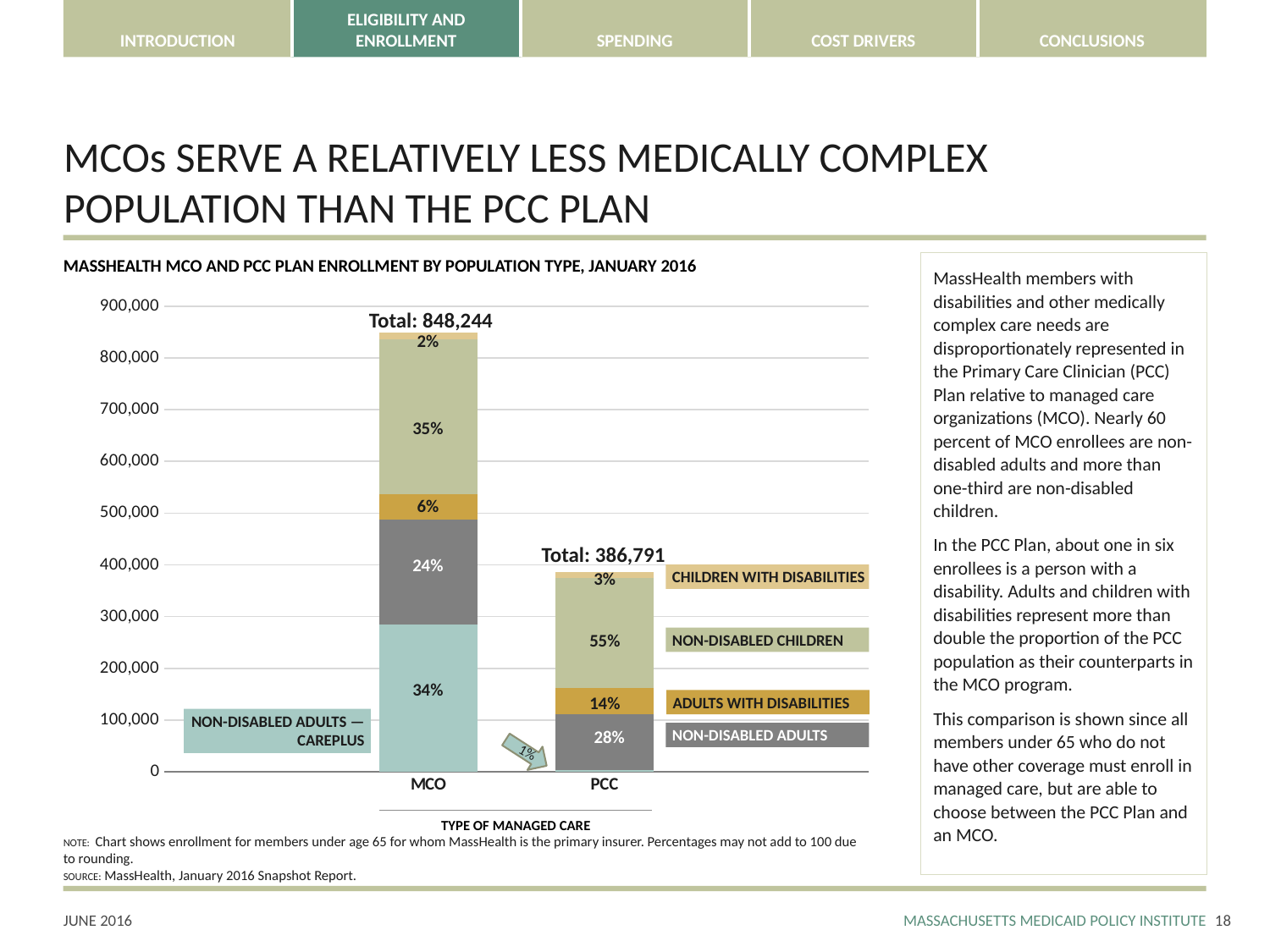
Is the total enrollment for PCC greater or less than 400,000? less What percentage of MCO enrollment is adults with disabilities? 6% What is the total enrollment shown for the MCO bar? 848,244 What percentage of MCO enrollment is non-disabled adults — CarePlus? 34% Which type of managed care has the larger total enrollment, MCO or PCC? MCO What is the difference in total enrollment between the MCO and PCC bars? 461,453 How many population types (segments) are labeled in the chart? 5 What percentage of PCC enrollment is children with disabilities? 3% What kind of chart is shown on the slide? Stacked bar chart By how many percentage points does the adults with disabilities share in PCC exceed that in MCO? 8 percentage points What is the total enrollment shown for the PCC bar? 386,791 What percentage of PCC enrollment is non-disabled children? 55%